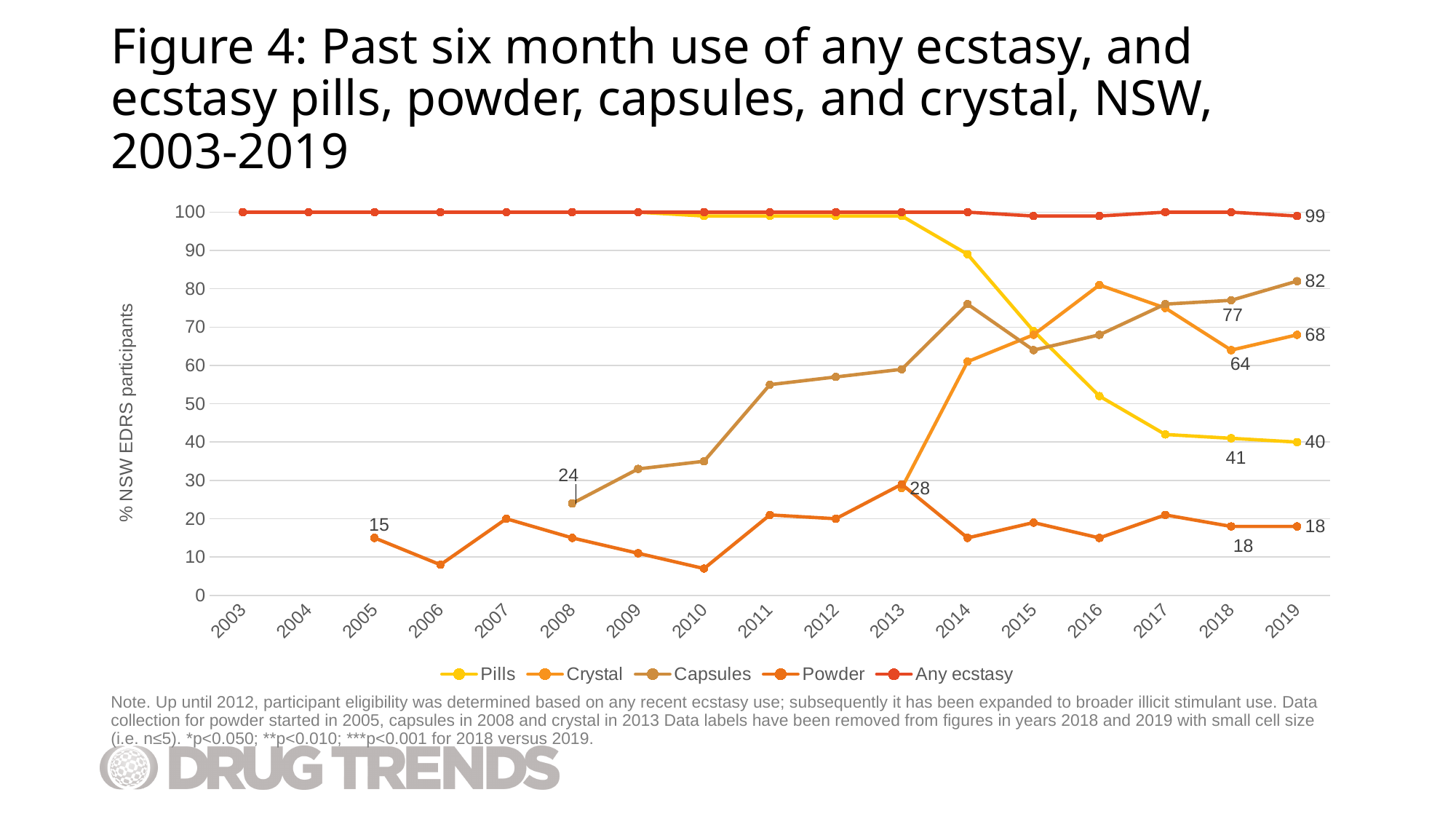
How many series does the legend list? 5 Does the Pills series rise or fall from 2013 to 2019? fall Which is larger in 2019, the value for Crystal or the value for Pills? Crystal What kind of chart is shown on the slide? line chart What is the value for Crystal in 2018? 64 What is the difference between the Capsules values in 2019 and 2018? 5 What is the value for Capsules in 2019? 82 What is the value for Powder in 2005? 15 Which series has the lowest value in 2019? Powder How many years are shown on the x axis? 17 Is the value for Pills in 2014 greater or less than 80? greater What is the value for Pills in 2019? 40